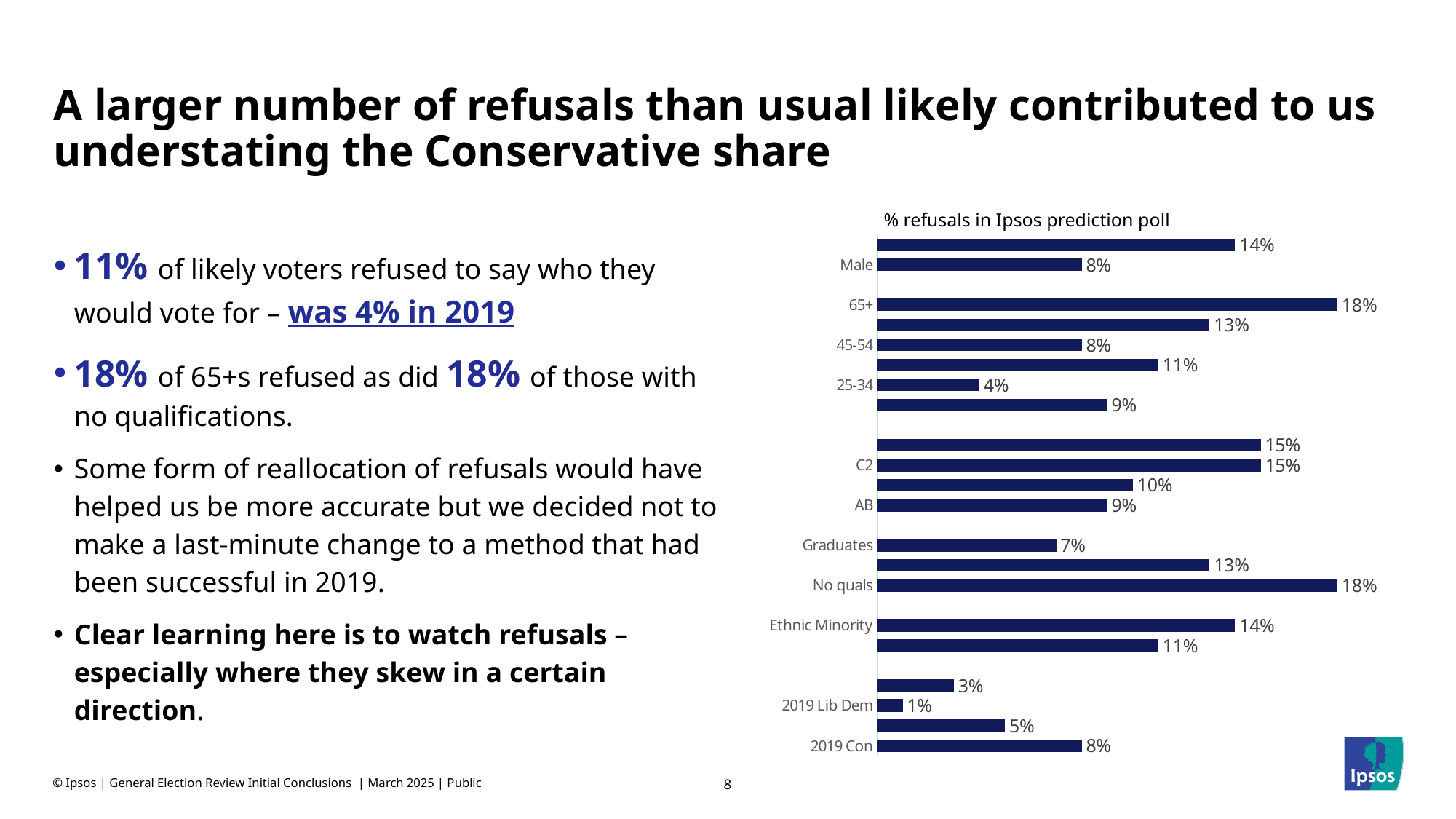
What is the refusal percentage for the Ethnic Minority group? 14% What is the refusal percentage for Graduates? 7% What is the refusal percentage for Male respondents? 8% What type of chart is shown on the slide? Bar chart Which labelled category has the lowest refusal percentage? 2019 Lib Dem Which has a higher refusal percentage, C2 or AB? C2 What is the refusal percentage for 2019 Lib Dem voters? 1% What is the difference in refusal percentage between No quals and Graduates? 11 percentage points What is the title of the chart? % refusals in Ipsos prediction poll What is the difference in refusal percentage between the 65+ group and the 25-34 group? 14 percentage points What is the refusal percentage for the 25-34 group? 4% What is the refusal percentage for the 65+ group in the chart? 18%